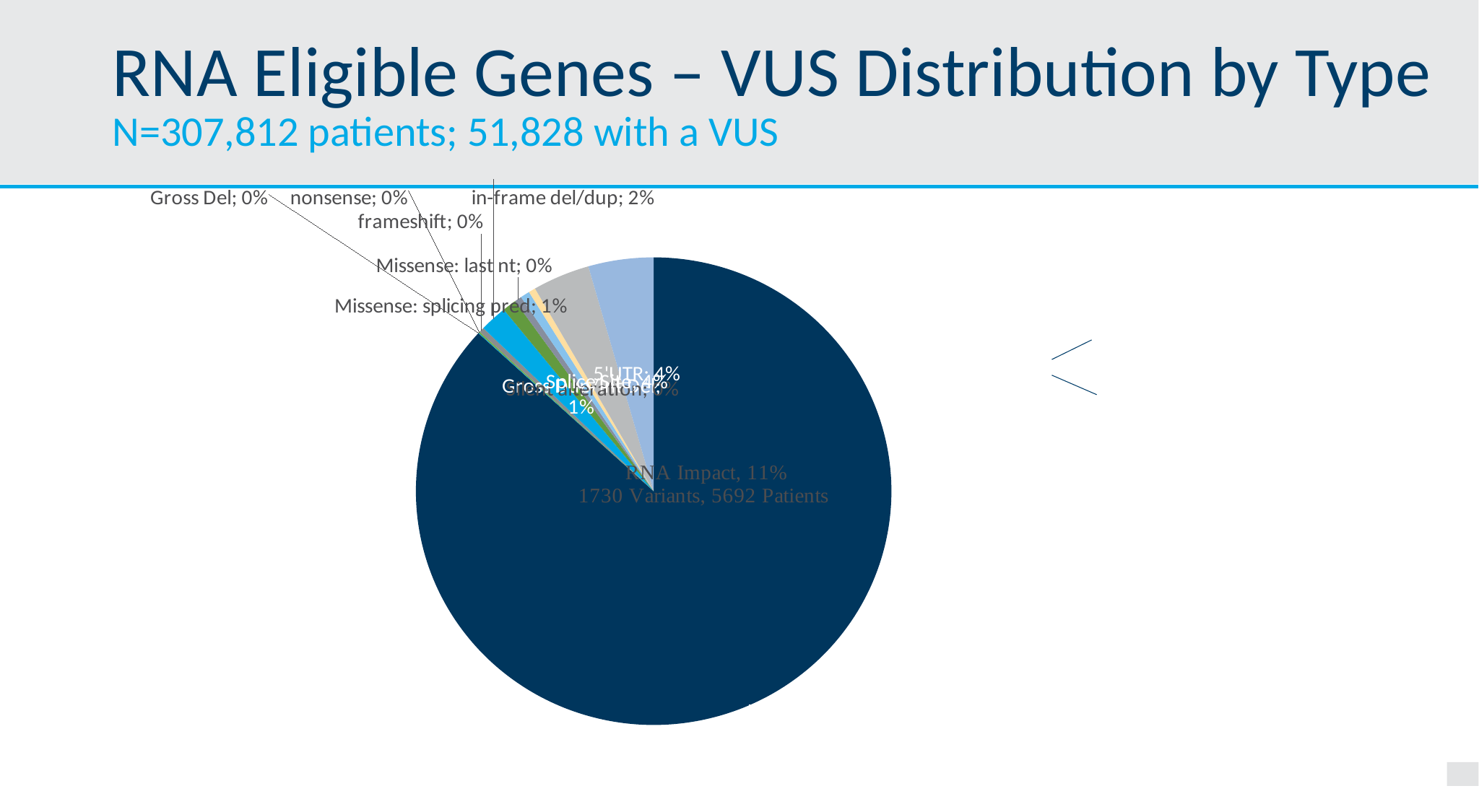
Which has the larger share of the pie, in-frame del/dup or 5'UTR? 5'UTR What percentage is shown for Gross Del? 0% What percentage is shown for frameshift? 0% What percentage of the pie is labelled for in-frame del/dup? 2% What percentage of the pie is labelled for 5'UTR? 4% What percentage is shown for Missense: splicing pred? 1% What kind of chart is shown on the slide? pie chart According to the subtitle, how many patients have a VUS? 51,828 What percentage is shown for nonsense? 0% What is the difference in percentage points between the 5'UTR slice and the in-frame del/dup slice? 2% What percentage is shown for Missense: last nt? 0% What is the title of the chart slide? RNA Eligible Genes – VUS Distribution by Type